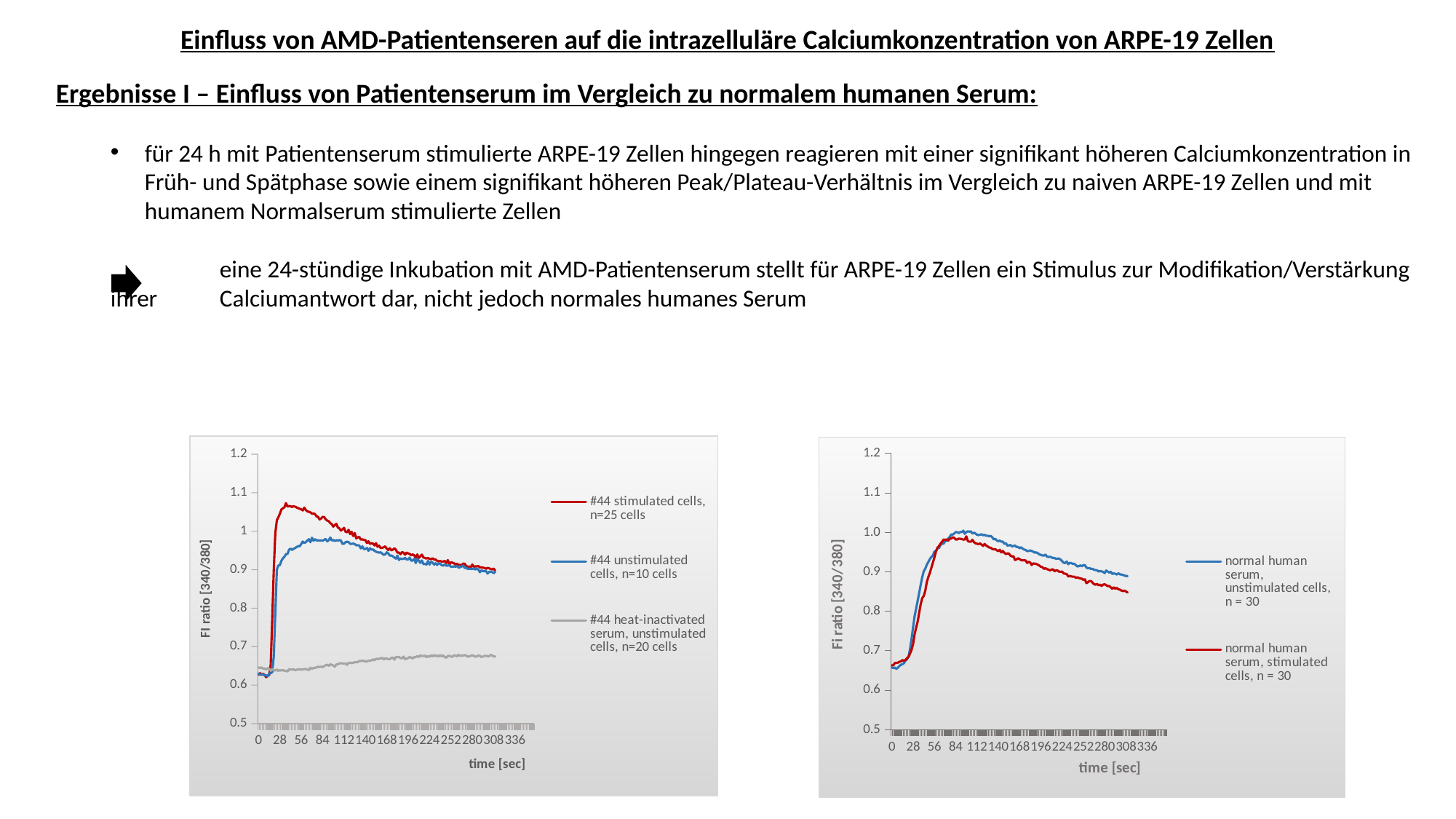
In the left chart, which series has the lowest values throughout the recording? #44 heat-inactivated serum, unstimulated cells, n=20 cells In the left chart, after the initial peak, do the values of the #44 stimulated cells series rise or fall as time increases? fall What is the label of the x axis of the right chart? time [sec] How many series does the legend of the left chart list? 3 In the right chart, is the value of the normal human serum, stimulated cells series at 308 sec greater or less than 0.9? less In the right chart, at 308 sec, which series has the larger value: normal human serum unstimulated cells or normal human serum stimulated cells? normal human serum, unstimulated cells, n = 30 In the right chart, what colour is the line for normal human serum, stimulated cells? red In the left chart, is the value of the #44 heat-inactivated serum series at 308 sec greater or less than 0.8? less In the left chart, which series reaches the highest peak value? #44 stimulated cells, n=25 cells In the left chart, is the peak value of the #44 stimulated cells series greater or less than 1.0? greater How many series does the legend of the right chart list? 2 What kind of chart is the chart on the left of the slide? line chart